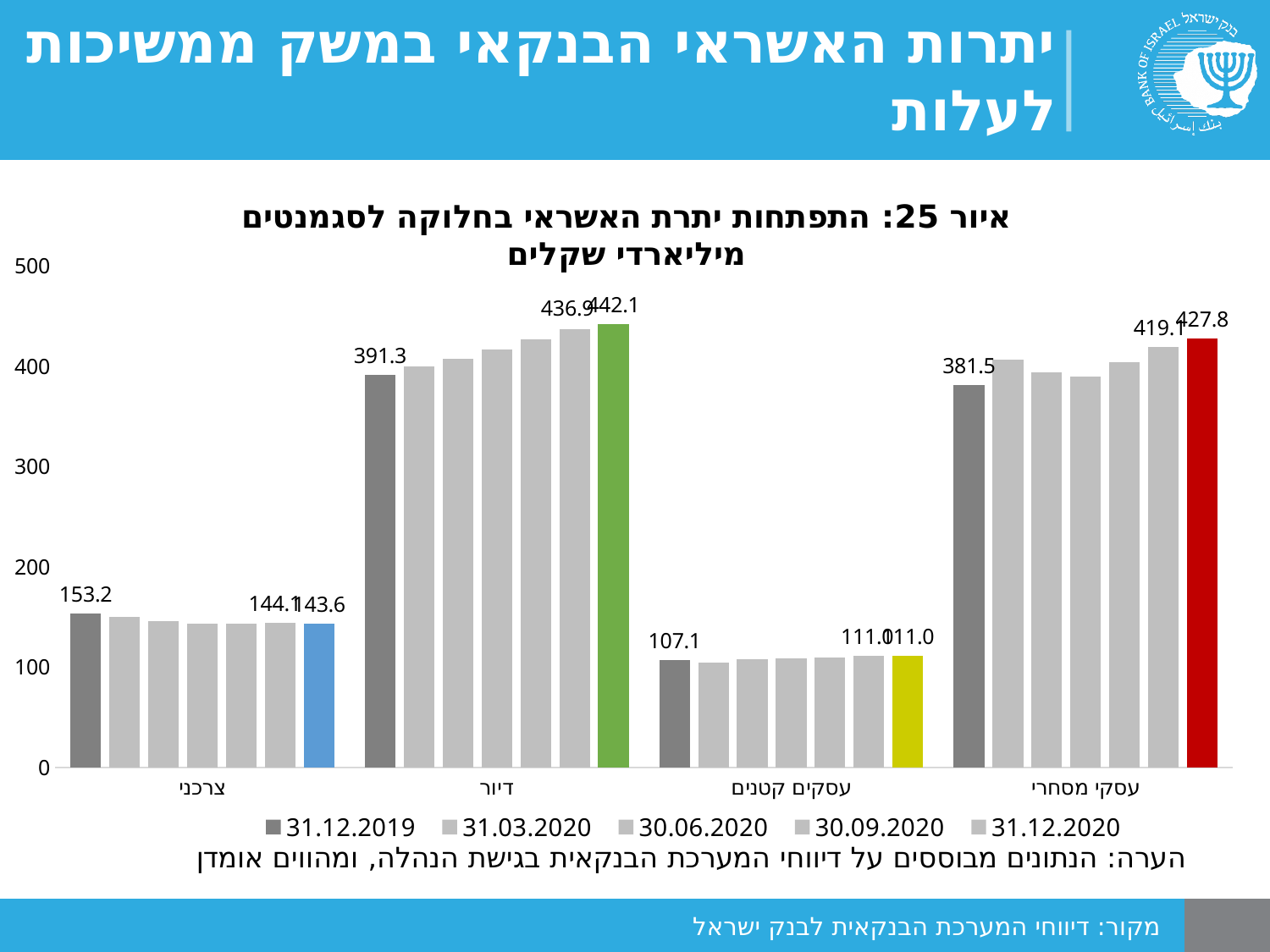
What is the value of the first (31.12.2019) bar for עסקי מסחרי? 381.5 Which category has the lowest bars in the chart? עסקים קטנים Do the bars for דיור rise or fall from left to right across the group? rise What is the title of the chart? איור 25: התפתחות יתרת האשראי בחלוקה לסגמנטים מיליארדי שקלים How many categories are shown on the x axis of the chart? 4 What is the difference between the 31.12.2019 values for דיור (391.3) and עסקי מסחרי (381.5)? 9.8 What is the value of the first (31.12.2019) bar for צרכני? 153.2 What is the value of the first (31.12.2019) bar for דיור? 391.3 Which category has the highest bars in the chart? דיור How many series does the chart's legend list? 5 What kind of chart is shown on the slide? bar chart What is the value of the first (31.12.2019) bar for עסקים קטנים? 107.1